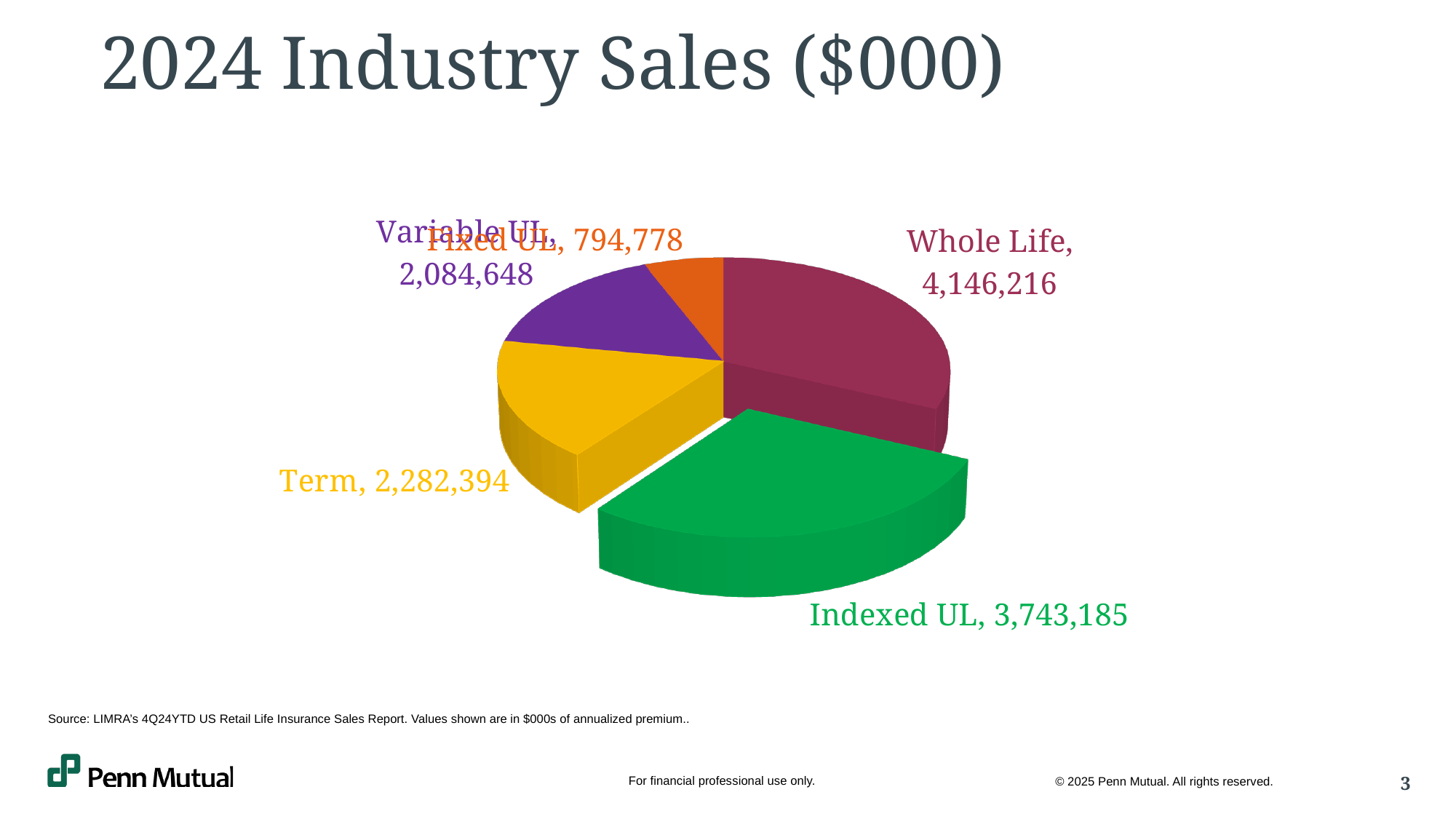
Which is larger, Term or Variable UL? Term What is the value for Indexed UL? 3,743,185 What is the value for Term? 2,282,394 What is the difference between the Term and Variable UL values? 197,746 What kind of chart is shown on the slide? Pie chart What is the value for Fixed UL? 794,778 What is the title of the chart? 2024 Industry Sales ($000) Which category has the lowest value? Fixed UL What is the value for Whole Life? 4,146,216 What is the difference between the Whole Life and Indexed UL values? 403,031 How many categories are shown in the pie chart? 5 Which category has the highest value? Whole Life